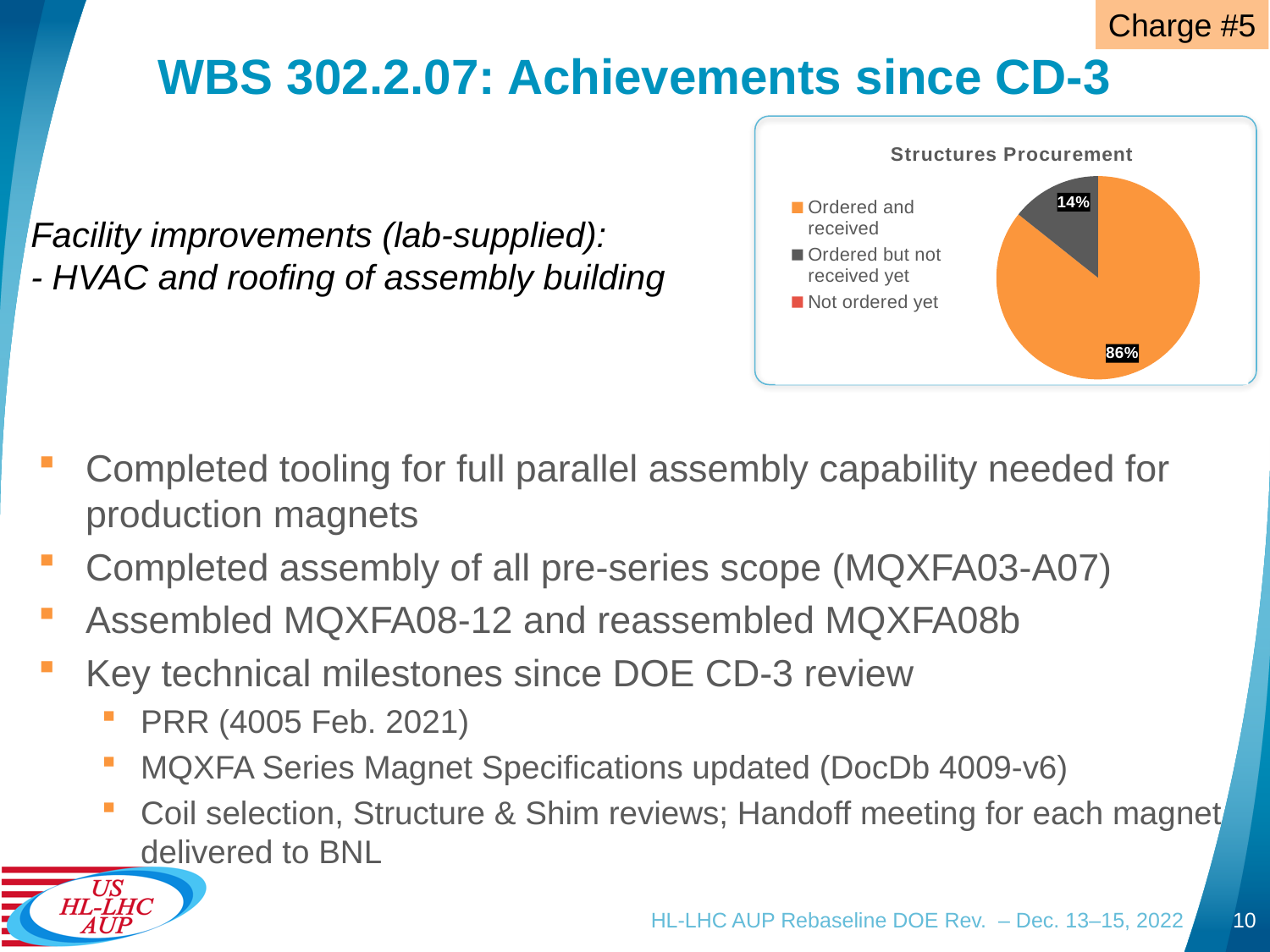
Which colour represents 'Ordered and received' in the Structures Procurement chart? orange Which legend category has the smallest visible slice in the Structures Procurement pie chart? Ordered but not received yet Which is larger in the Structures Procurement chart: 'Ordered and received' or 'Ordered but not received yet'? Ordered and received What is the title of the chart on the slide? Structures Procurement Which category has the largest slice in the Structures Procurement pie chart? Ordered and received What is the difference in percentage points between the 'Ordered and received' and 'Ordered but not received yet' slices? 72 How many entries does the legend of the Structures Procurement chart list? 3 What kind of chart is shown on the slide? pie chart What share of the Structures Procurement pie is 'Ordered but not received yet'? 14% What share of the Structures Procurement pie is 'Ordered and received'? 86% Is the share for 'Ordered and received' greater or less than 50%? greater